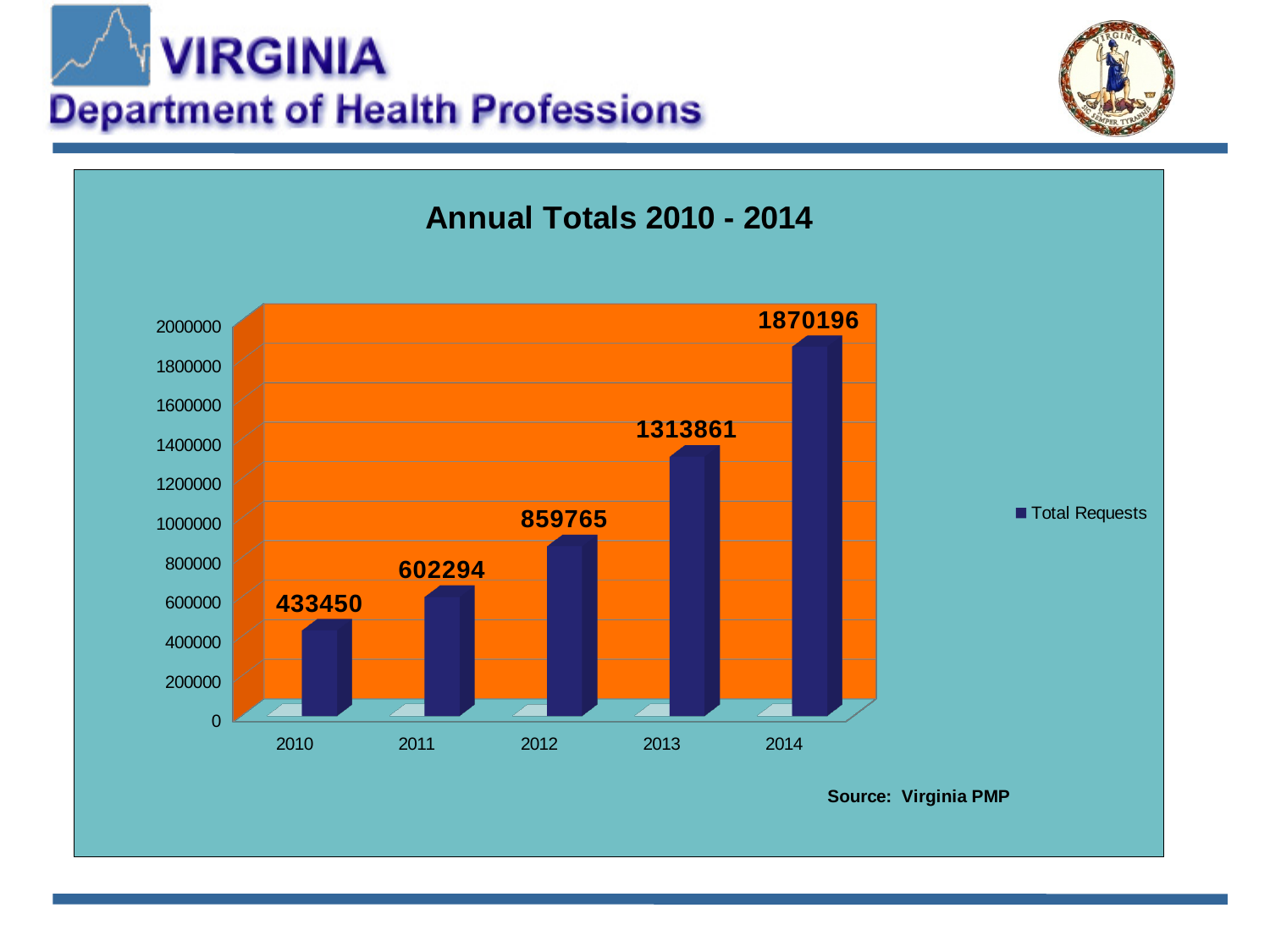
What is the value for Total Requests in 2014? 1870196 Do the Total Requests values rise or fall from 2010 to 2014? rise What kind of chart is shown on the slide? bar chart What is the value for Total Requests in 2010? 433450 What is the difference between Total Requests in 2011 and 2010? 168844 Is the value for 2013 greater or less than 1200000? greater Which is larger, Total Requests in 2012 or in 2013? 2013 What is the difference between Total Requests in 2014 and 2013? 556335 Which year has the lowest Total Requests? 2010 Which year has the highest Total Requests? 2014 How many years are shown on the x axis? 5 What is the value for Total Requests in 2012? 859765